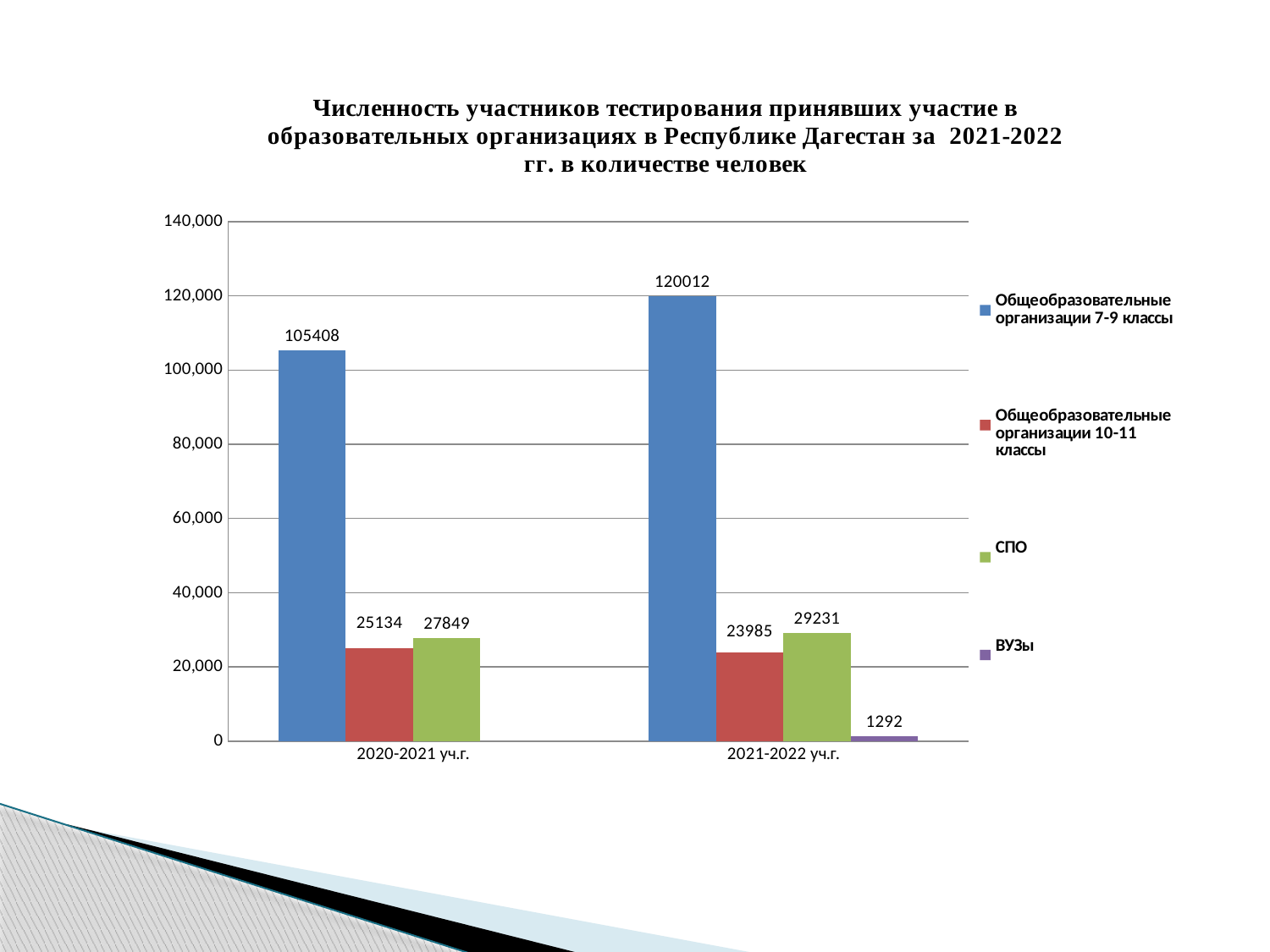
What is the difference between the values for Общеобразовательные организации 7-9 классы in 2021-2022 уч.г. and 2020-2021 уч.г.? 14604 What kind of chart is shown on the slide? bar chart What is the value for ВУЗы in 2021-2022 уч.г.? 1292 What is the value for Общеобразовательные организации 7-9 классы in 2021-2022 уч.г.? 120012 What is the value for СПО in 2020-2021 уч.г.? 27849 How many series does the legend list? 4 Which series has the lowest value in 2021-2022 уч.г.? ВУЗы Is the value for Общеобразовательные организации 7-9 классы in 2020-2021 уч.г. greater or less than 100,000? greater Which series has the highest value in 2021-2022 уч.г.? Общеобразовательные организации 7-9 классы Does the value for Общеобразовательные организации 10-11 классы rise or fall from 2020-2021 уч.г. to 2021-2022 уч.г.? fall Which is larger: СПО in 2020-2021 уч.г. or СПО in 2021-2022 уч.г.? СПО in 2021-2022 уч.г. What is the value for Общеобразовательные организации 10-11 классы in 2020-2021 уч.г.? 25134